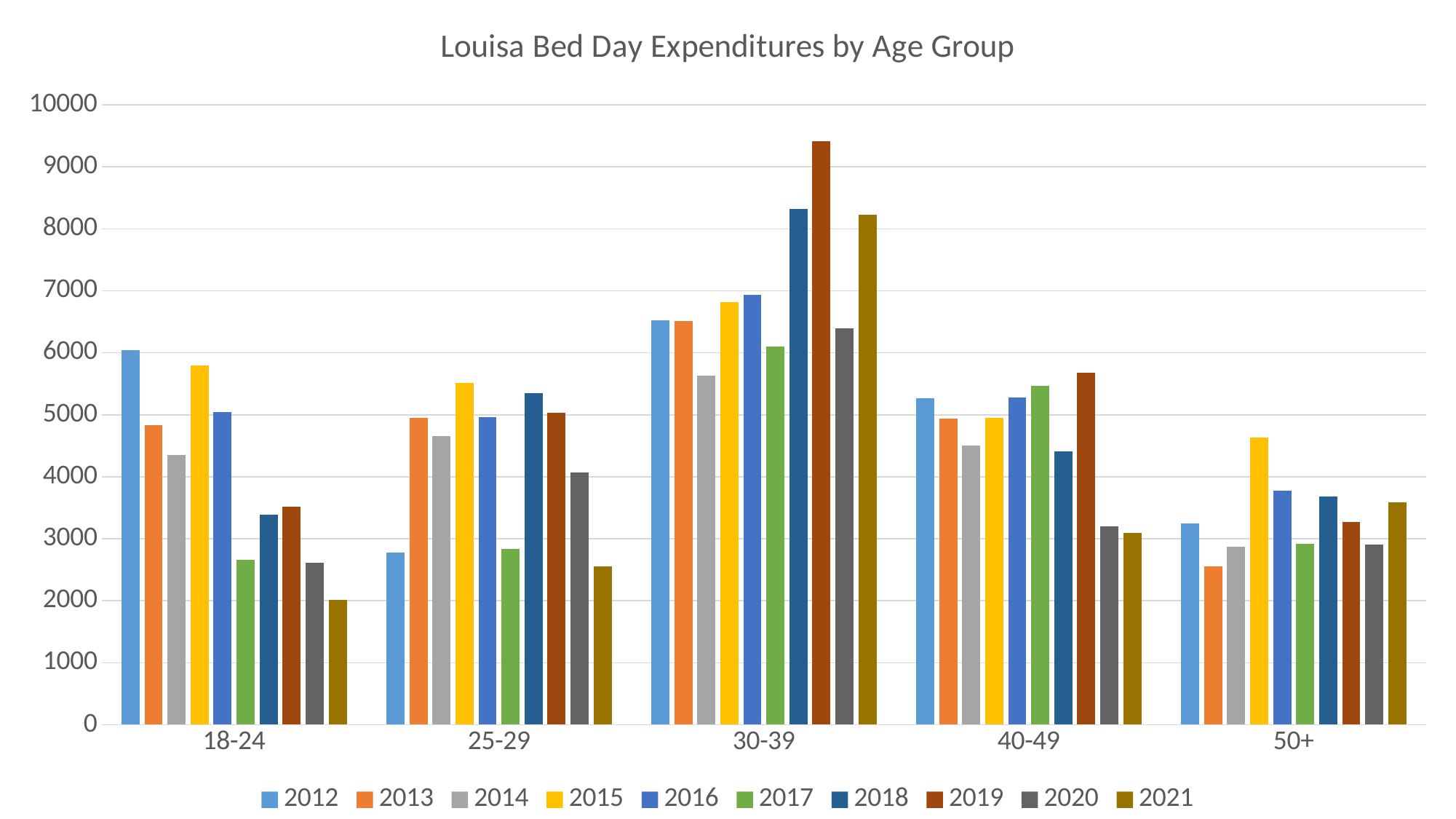
Is the value for 2019 in the 30-39 age group greater or less than 9000? greater What is the title of the chart? Louisa Bed Day Expenditures by Age Group What kind of chart is shown on the slide? bar chart How many age groups are shown on the x axis? 5 Which age group has the highest bar for 2019? 30-39 In the 18-24 age group, which year has the lowest bar? 2021 Is the value for 2018 in the 30-39 age group greater or less than 8000? greater In the 30-39 age group, which year has the lowest bar? 2014 In the 18-24 age group, which is larger, the 2012 bar or the 2013 bar? 2012 Is the value for 2021 in the 18-24 age group greater or less than 3000? less How many series does the legend list? 10 In the 50+ age group, which year has the highest bar? 2015